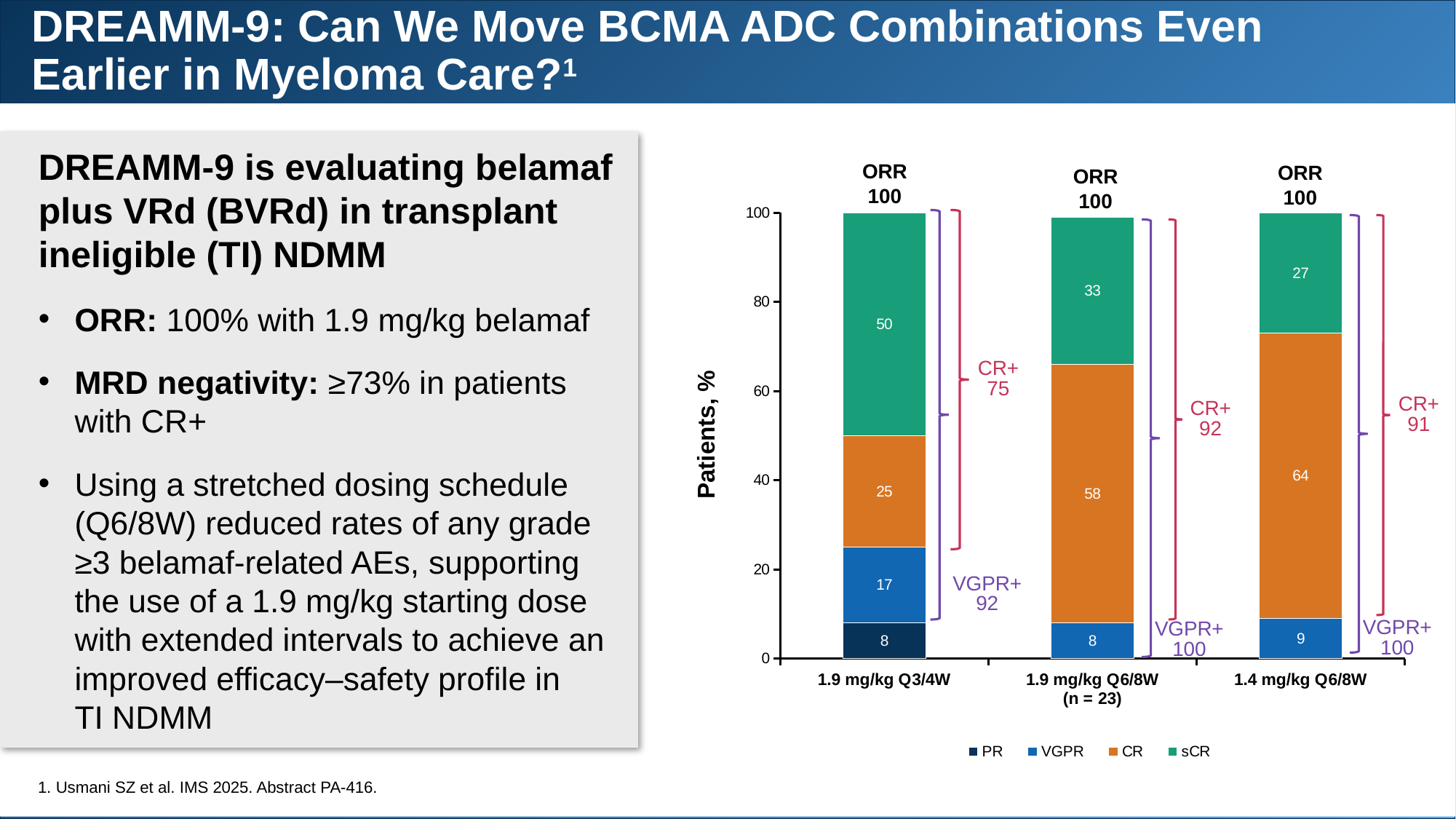
Which dosing group has the lowest sCR value? 1.4 mg/kg Q6/8W What is the sCR value for the 1.9 mg/kg Q3/4W group? 50 What type of chart is shown on the slide? stacked bar chart How many dosing groups (categories) are shown on the x axis? 3 What is the total of the stacked bar for the 1.9 mg/kg Q3/4W group? 100 What is the CR value for the 1.9 mg/kg Q6/8W group? 58 How many series does the legend list? 4 Which dosing group has the highest CR value? 1.4 mg/kg Q6/8W What is the difference between the CR values of the 1.4 mg/kg Q6/8W group and the 1.9 mg/kg Q3/4W group? 39 What is the VGPR value for the 1.4 mg/kg Q6/8W group? 9 Is the sCR value larger for the 1.9 mg/kg Q3/4W group or the 1.9 mg/kg Q6/8W group? 1.9 mg/kg Q3/4W What is the CR+ rate shown for the 1.9 mg/kg Q3/4W group? 75